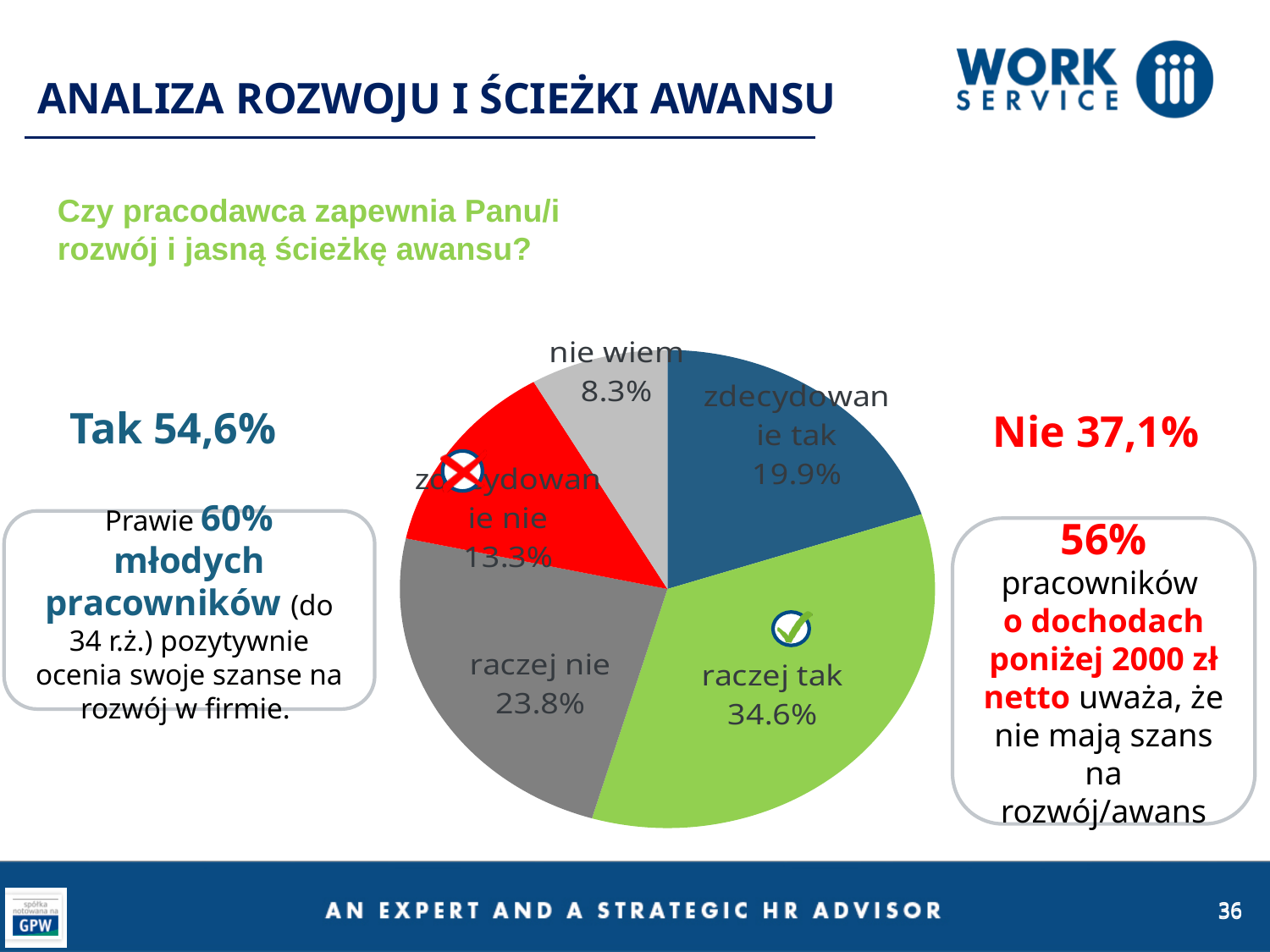
Which slice of the pie chart is the largest? raczej tak What is the value for "raczej nie" in the pie chart? 23.8% What is the difference between the "raczej tak" and "raczej nie" slices? 10.8% What is the value for "zdecydowanie nie" in the pie chart? 13.3% What is the value for "zdecydowanie tak" in the pie chart? 19.9% What colour is the "raczej tak" slice in the pie chart? green Which is larger, "zdecydowanie tak" or "zdecydowanie nie"? zdecydowanie tak Which slice of the pie chart is the smallest? nie wiem What kind of chart is shown on the slide? pie chart What share of the pie does "raczej tak" represent? 34.6% How many slices does the pie chart have? 5 What is the value for "nie wiem" in the pie chart? 8.3%